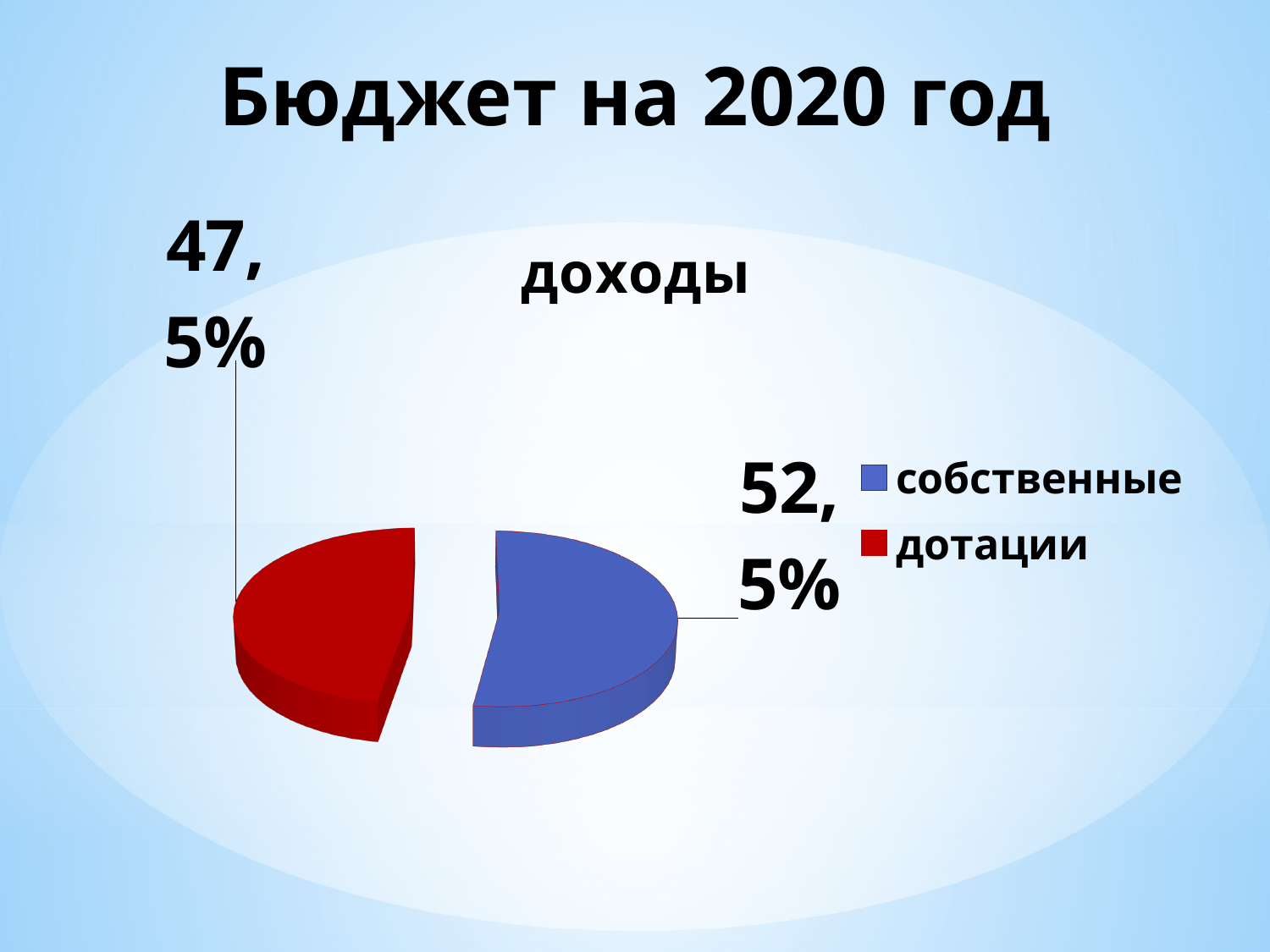
Which is larger, the slice for собственные or the slice for дотации? собственные What kind of chart is shown on the slide? pie chart Which category has the smallest slice of the pie? дотации How many slices does the pie chart have? 2 What colour is the slice for дотации? red Is the share for дотации greater or less than 50%? less What is the title of the chart? доходы Which category has the largest slice of the pie? собственные What is the difference in percentage points between the собственные slice and the дотации slice? 5 What share of the pie does the slice for собственные represent? 52,5% How many entries does the legend list? 2 What share of the pie does the slice for дотации represent? 47,5%